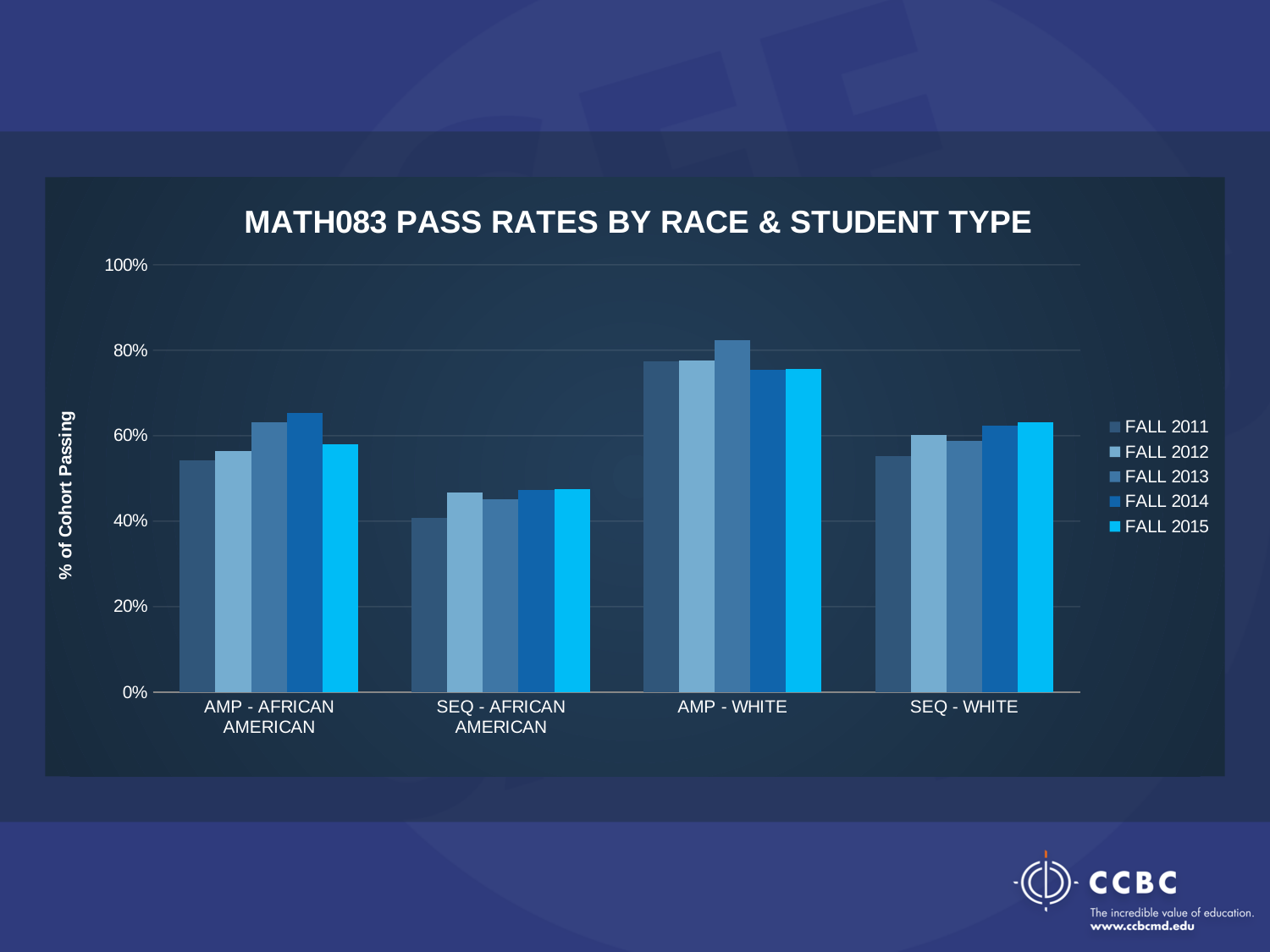
Is the FALL 2011 value for AMP - AFRICAN AMERICAN greater or less than 60%? less Which category has the lowest FALL 2011 pass rate? SEQ - AFRICAN AMERICAN Within the AMP - WHITE category, which series has the highest bar? FALL 2013 How many series does the legend list? 5 What kind of chart is shown on the slide? bar chart Which has the larger FALL 2011 value: AMP - WHITE or SEQ - WHITE? AMP - WHITE How many categories are shown on the x axis? 4 Is the FALL 2013 value for AMP - WHITE greater or less than 80%? greater Is the FALL 2015 value for SEQ - AFRICAN AMERICAN greater or less than 60%? less What is the title of the y axis? % of Cohort Passing Which category has the highest FALL 2013 pass rate? AMP - WHITE For AMP - AFRICAN AMERICAN, which is larger: the FALL 2014 value or the FALL 2015 value? FALL 2014